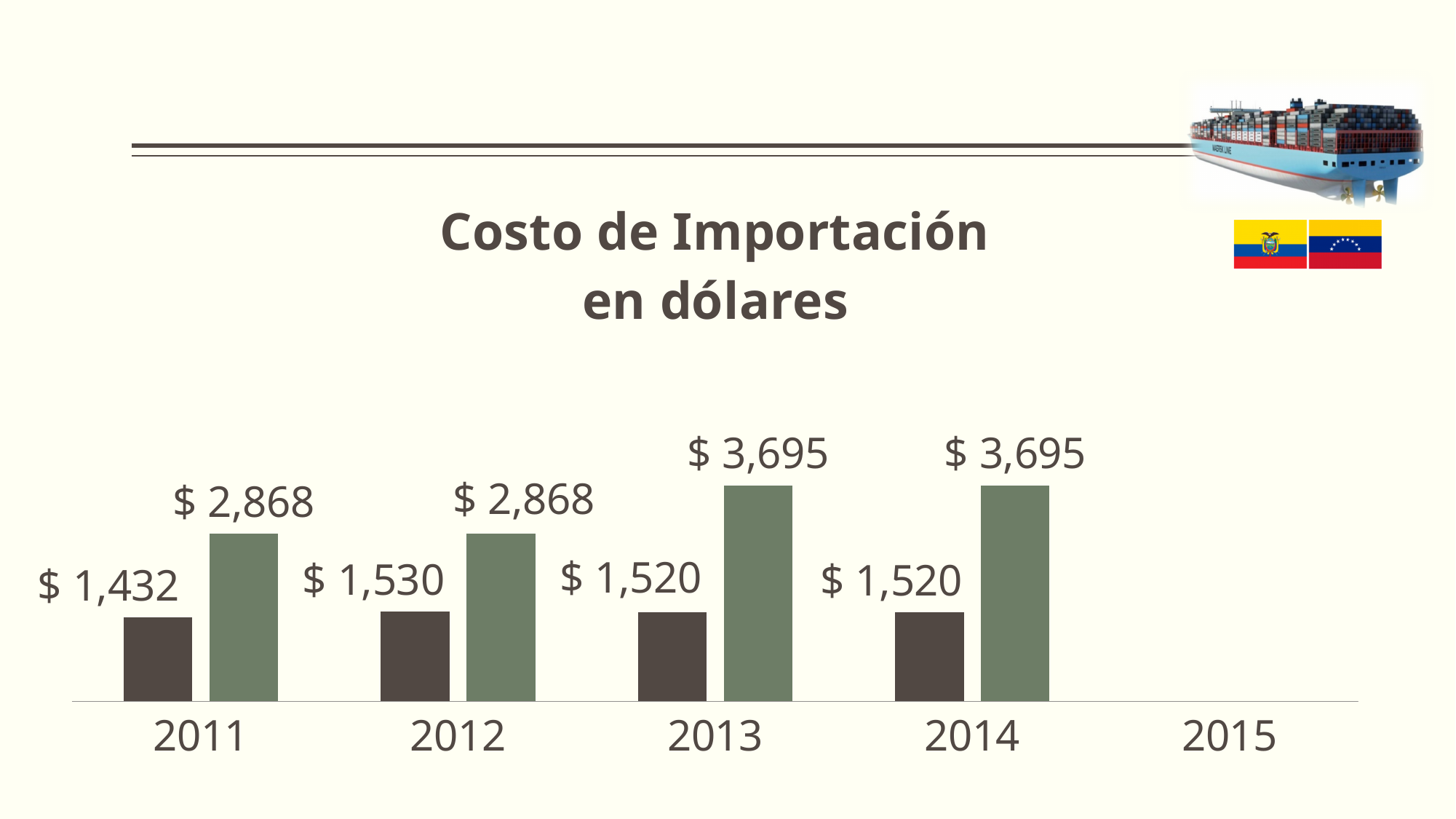
Which is larger, the green bar for 2012 or the green bar for 2014? 2014 What is the difference between the green bar and the dark brown bar in 2013? $ 2,175 What kind of chart is shown on the slide? Bar chart In which year is the dark brown bar lowest? 2011 What is the value of the dark brown bar for 2012? $ 1,530 What is the value of the green bar for 2013? $ 3,695 What is the value of the green bar for 2011? $ 2,868 In which year is the dark brown bar highest? 2012 How many years are shown on the x axis? 5 What is the difference between the dark brown bar in 2012 and the dark brown bar in 2011? $ 98 Do the green bars rise or fall from 2011 to 2014? Rise What is the value of the dark brown bar for 2011? $ 1,432